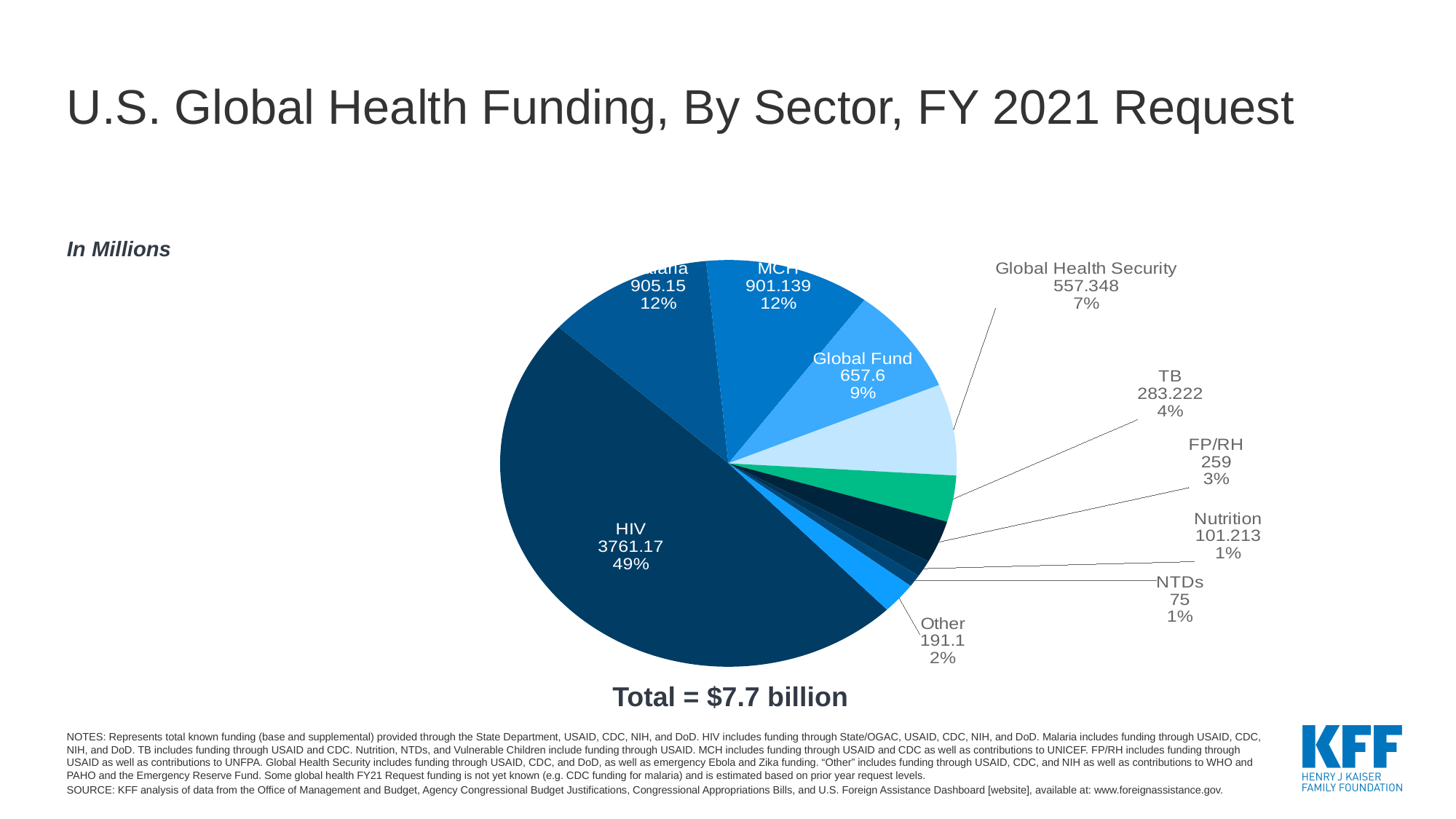
Which sector has the smallest value on the pie chart? NTDs What is the difference between the FP/RH value and the NTDs value? 184 Which sector has the largest slice of the pie? HIV How many sectors (slices) are shown on the pie chart? 10 What is the value shown for HIV on the pie chart? 3761.17 What share of the pie does HIV represent? 49% Which is larger, Global Health Security or TB? Global Health Security What total is stated below the pie chart? $7.7 billion What kind of chart is shown on the slide? Pie chart What is the value shown for TB? 283.222 What is the value shown for Nutrition? 101.213 What is the value shown for Global Fund? 657.6